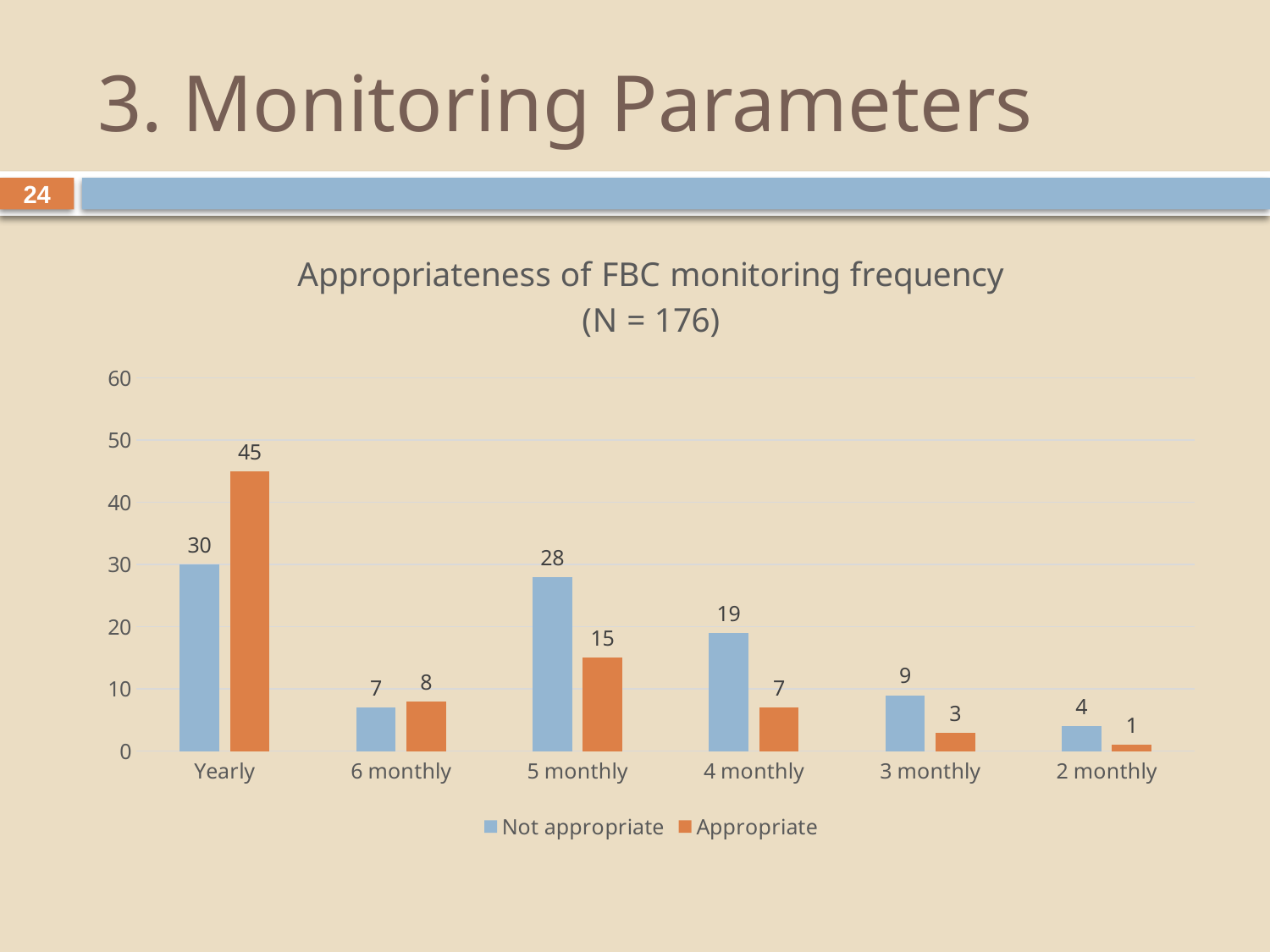
What is the value for Appropriate in the 2 monthly category? 1 Which category has the lowest Not appropriate value? 2 monthly What is the title of the chart? Appropriateness of FBC monitoring frequency (N = 176) What is the value for Appropriate in the 5 monthly category? 15 How many categories are shown on the x axis? 6 Which is larger for 4 monthly: Not appropriate or Appropriate? Not appropriate What is the difference between the Appropriate and Not appropriate values for Yearly? 15 What is the value for Not appropriate in the Yearly category? 30 Which category has the highest Appropriate value? Yearly Is the Not appropriate value for 5 monthly greater or less than 20? greater How many series does the legend list? 2 What kind of chart is shown? Bar chart